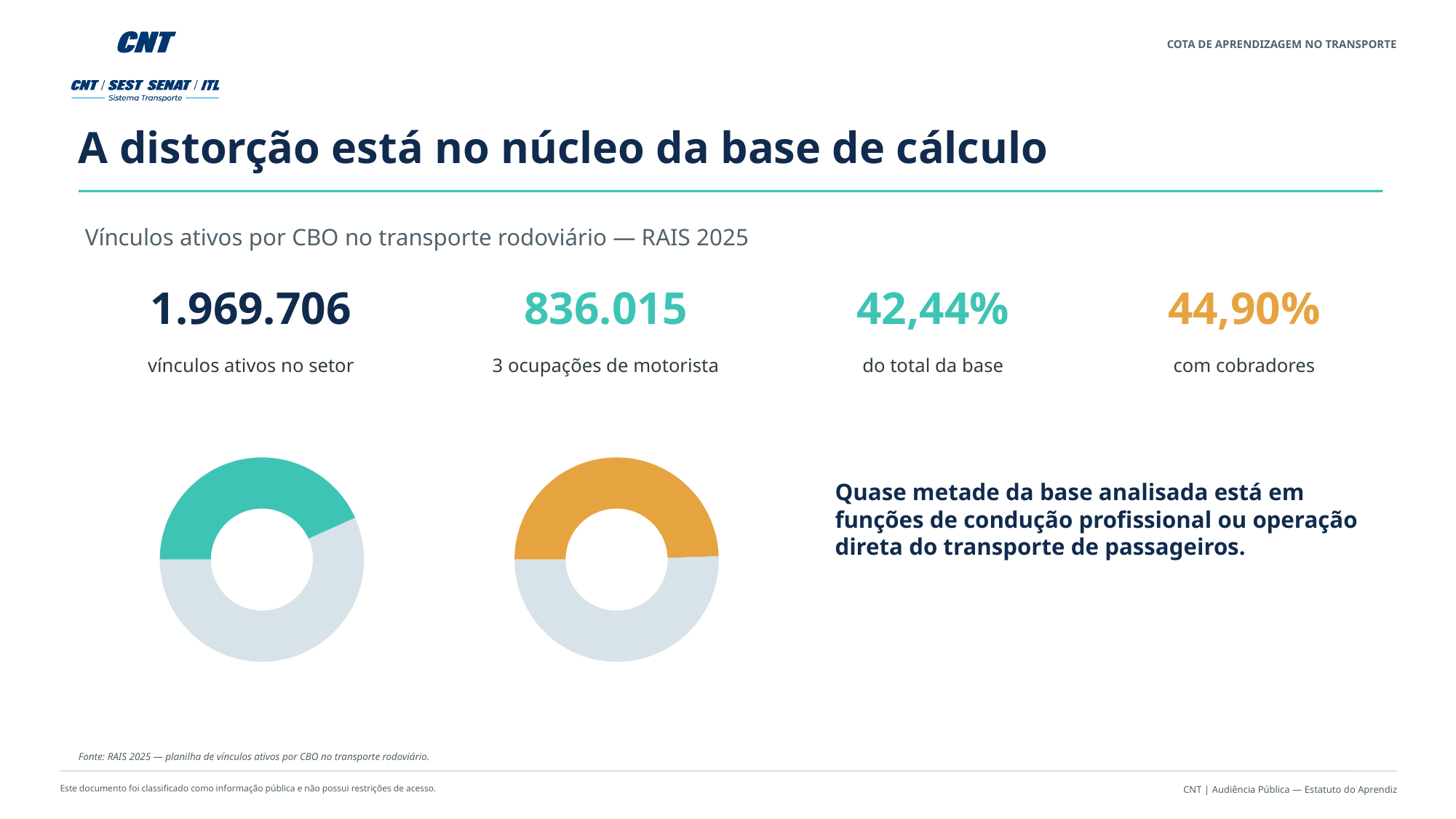
What colour is the filled segment of the left donut chart? Teal What is the total number of active links (vínculos ativos) in the sector shown on the slide? 1.969.706 Is the filled (teal) share of the left donut chart greater or less than 50%? less Which donut chart has the larger filled share, the teal one on the left or the orange one on the right? The orange one on the right How many links are attributed to the 3 driver occupations (ocupações de motorista)? 836.015 What kind of charts are shown on the slide? Donut charts What is the difference between the orange share (44,90%) and the teal share (42,44%)? 2,46 percentage points How many donut charts are on the slide? 2 What is the subtitle describing the data shown on the slide? Vínculos ativos por CBO no transporte rodoviário — RAIS 2025 What percentage is shown in orange, matching the right donut chart? 44,90% What percentage is shown in teal, matching the left donut chart? 42,44%